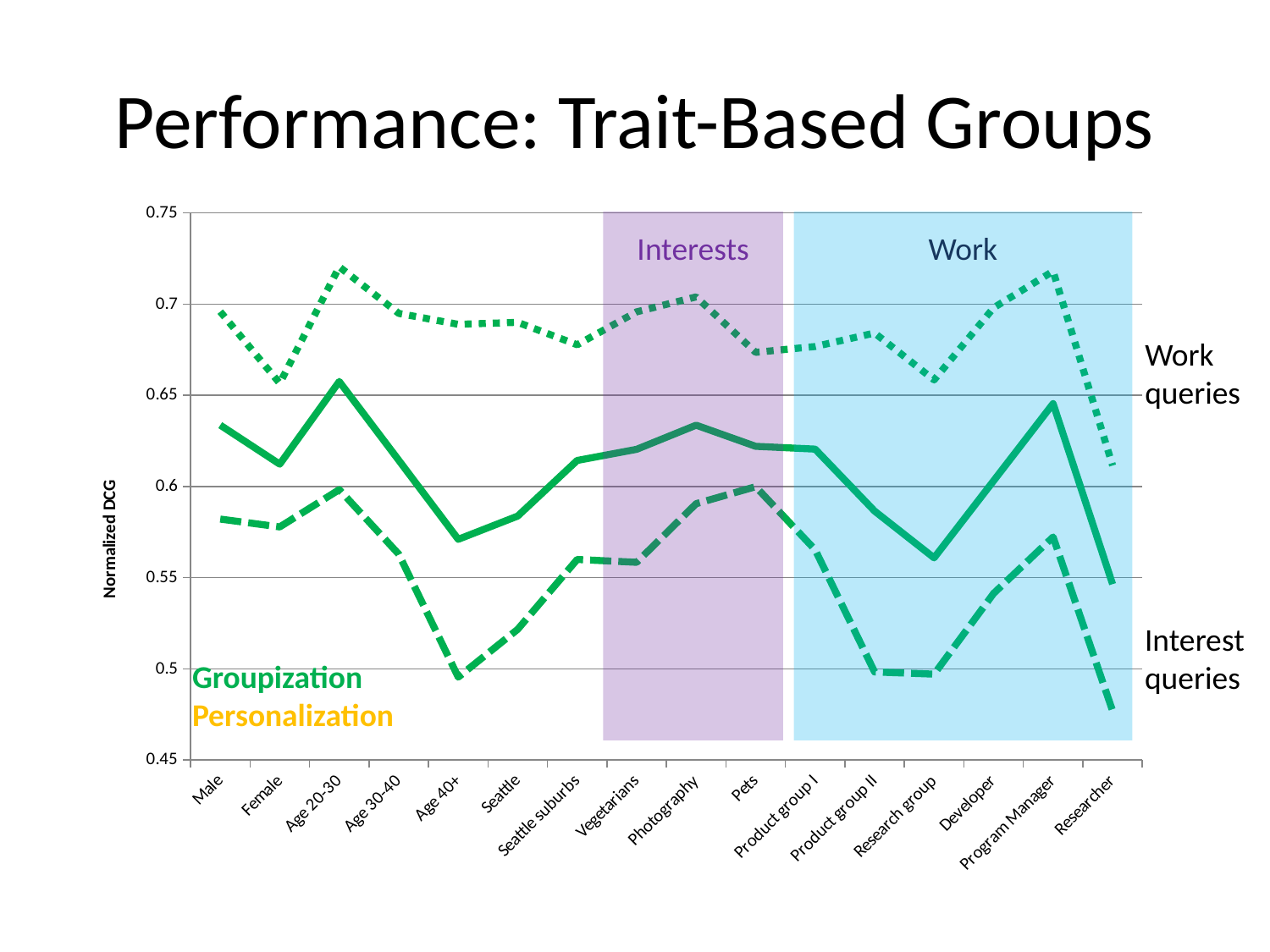
For the Male category, which line has the higher value: the Work queries (dotted) line or the Interest queries (dashed) line? Work queries (dotted) Does the Interest queries (dashed) line rise or fall from Age 20-30 to Age 40+? fall For the solid line, which category has the higher value: Male or Age 40+? Male What is the label on the y axis of the chart? Normalized DCG How many categories are shown along the x axis of the chart? 16 Is the value of the Work queries (dotted) line for Researcher greater or less than 0.6? greater Is the value of the Work queries (dotted) line for Age 20-30 greater or less than 0.7? greater Is the value of the solid line for Program Manager greater or less than 0.6? greater What kind of chart is shown on the slide? line chart What is the title of the slide containing the chart? Performance: Trait-Based Groups